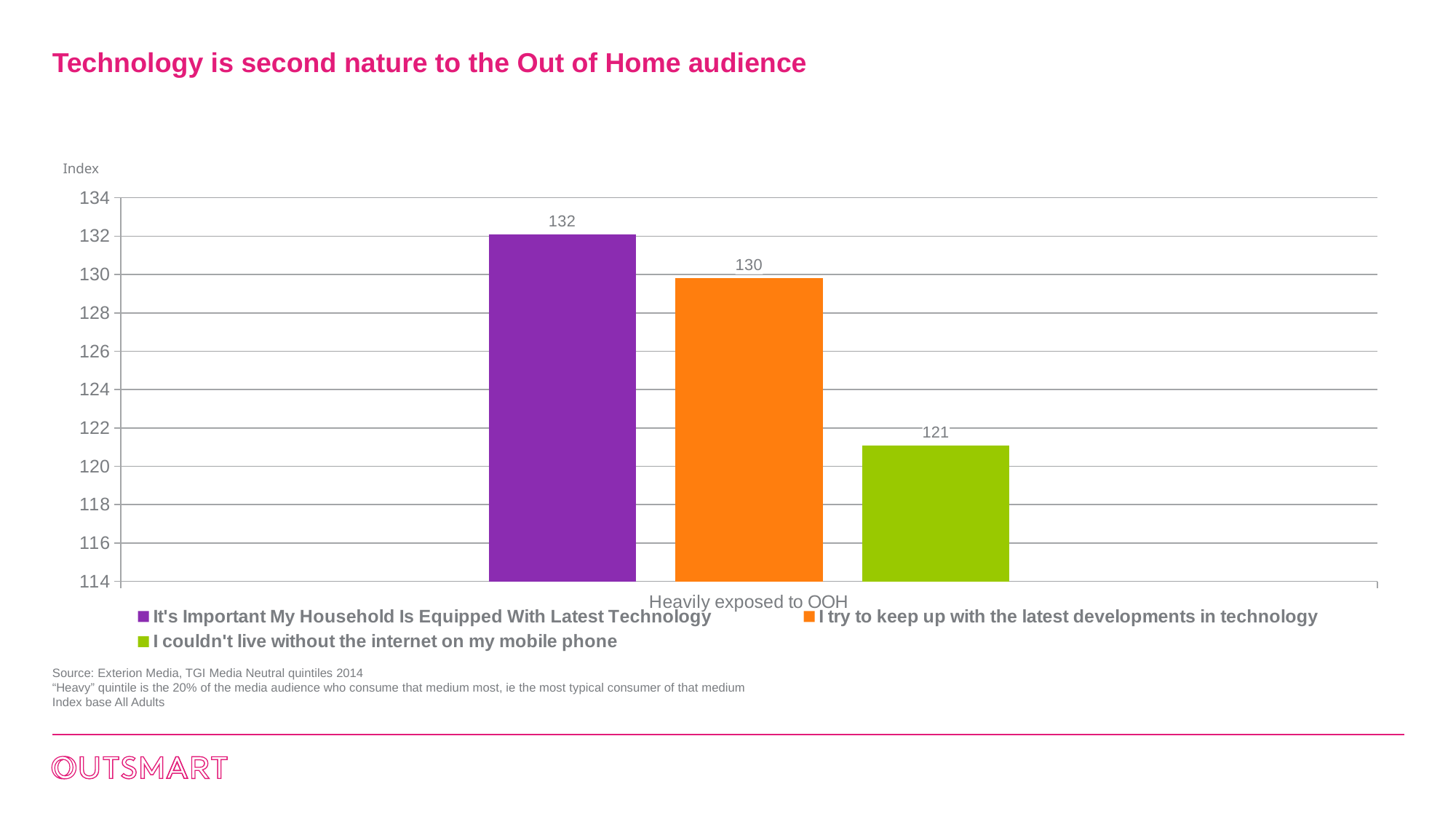
What is the difference between the index for "I try to keep up with the latest developments in technology" and "I couldn't live without the internet on my mobile phone"? 9 What is the title of the slide? Technology is second nature to the Out of Home audience What is the difference between the index for "It's Important My Household Is Equipped With Latest Technology" and "I couldn't live without the internet on my mobile phone"? 11 What is the index value for "I try to keep up with the latest developments in technology"? 130 Which series has the highest index value? It's Important My Household Is Equipped With Latest Technology How many series does the legend list? 3 What is the index value for "It's Important My Household Is Equipped With Latest Technology"? 132 Which is larger: the index for "I try to keep up with the latest developments in technology" or for "I couldn't live without the internet on my mobile phone"? I try to keep up with the latest developments in technology Which series has the lowest index value? I couldn't live without the internet on my mobile phone What is the index value for "I couldn't live without the internet on my mobile phone"? 121 What is the category label shown on the x axis? Heavily exposed to OOH What kind of chart is shown on the slide? Bar chart